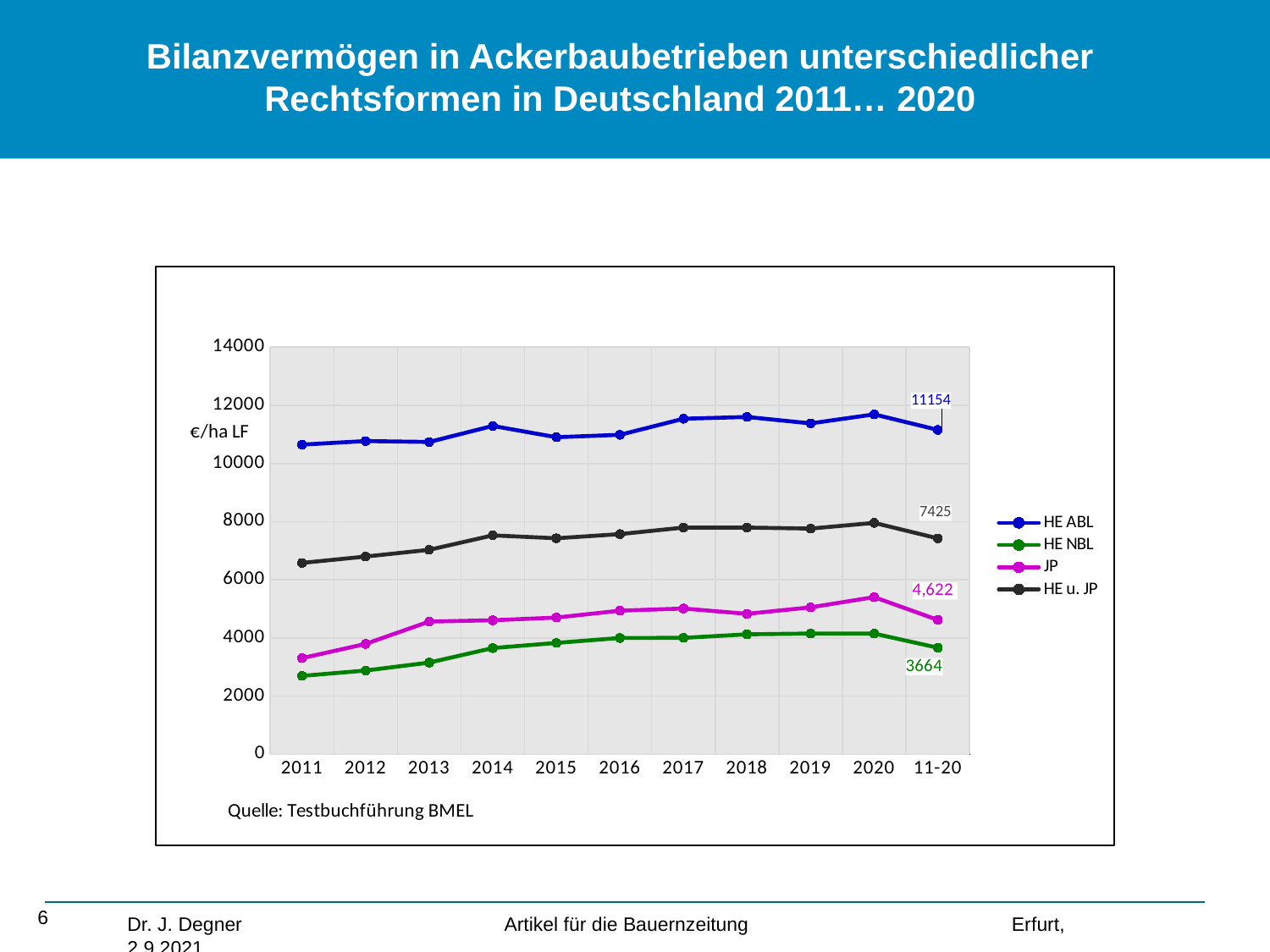
What is the difference between the HE ABL and HE u. JP values at 11-20? 3729 What unit is shown on the y axis of the chart? €/ha LF Which series has the highest value at 11-20? HE ABL Is the value for HE NBL in 2011 greater or less than 4000? less How many series does the legend list? 4 Is the value for HE ABL in 2011 greater or less than 10000? greater What is the value for HE NBL at 11-20? 3664 What is the value for JP at 11-20? 4,622 What is the value for HE ABL at 11-20? 11154 What is the value for HE u. JP at 11-20? 7425 Which series has the lowest value at 11-20? HE NBL What kind of chart is shown on the slide? line chart